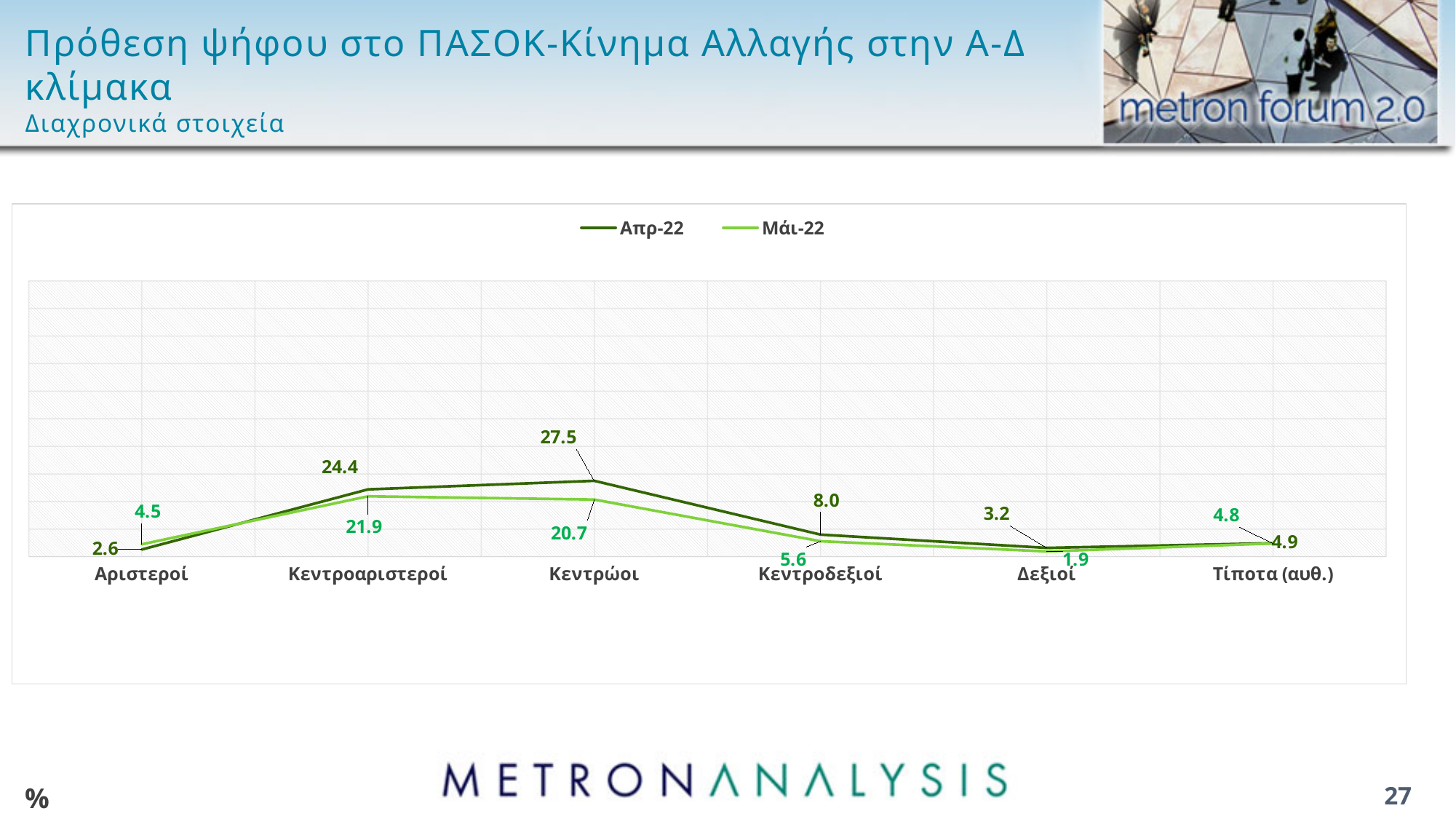
What is the Απρ-22 value for Κεντρώοι? 27.5 What is the difference between the Απρ-22 and Μάι-22 values for Κεντρώοι? 6.8 What is the Μάι-22 value for Κεντροαριστεροί? 21.9 How many series does the legend list? 2 Which is larger for Αριστεροί, the Απρ-22 value or the Μάι-22 value? Μάι-22 What is the Απρ-22 value for Κεντροδεξιοί? 8.0 What is the Μάι-22 value for Δεξιοί? 1.9 Which series is drawn in the darker green line? Απρ-22 What kind of chart is shown on the slide? Line chart Which category has the highest Απρ-22 value? Κεντρώοι Which category has the lowest Μάι-22 value? Δεξιοί How many categories are shown on the x axis? 6